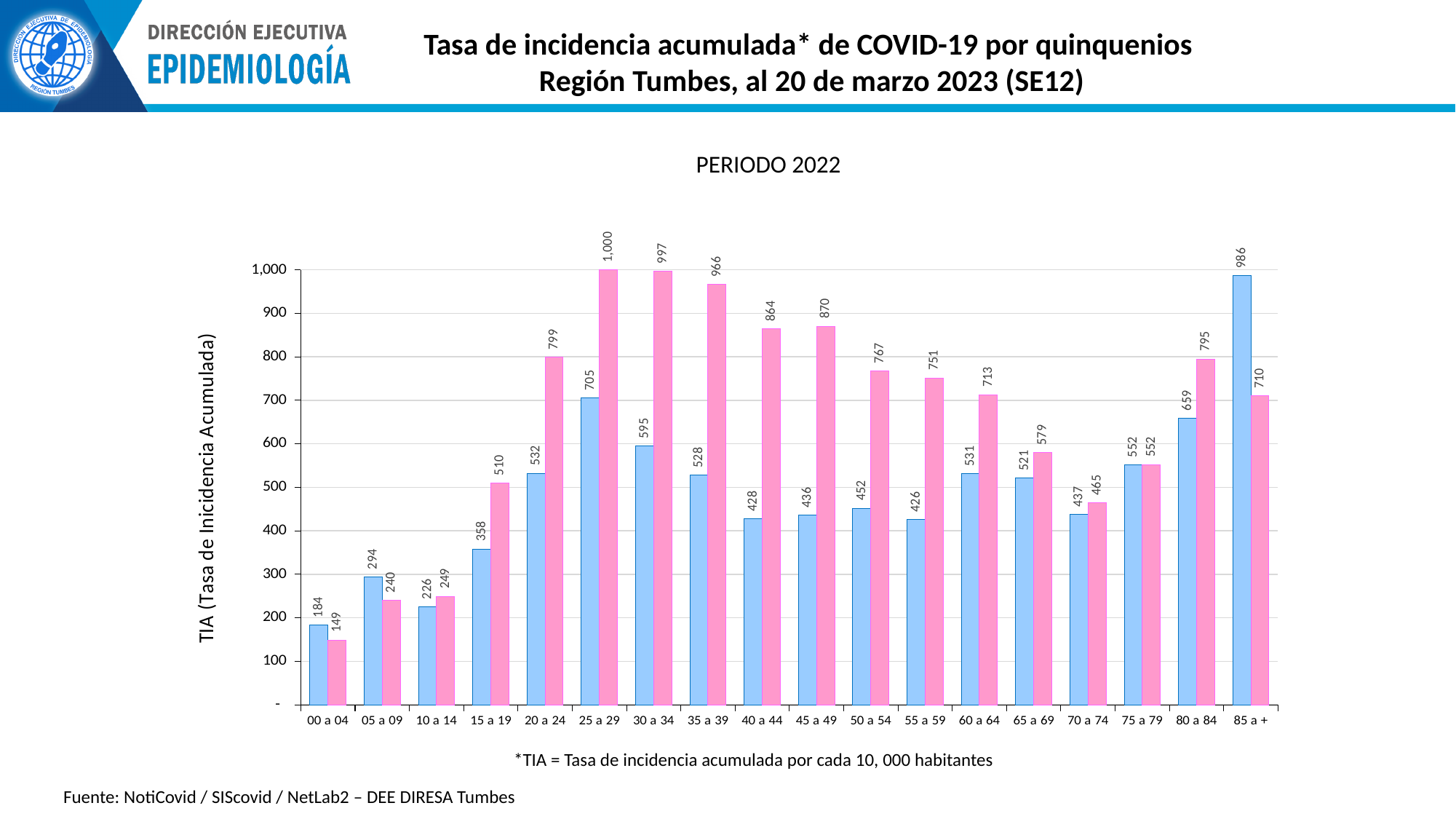
Which age group has the highest pink bar? 25 a 29 What is the difference between the pink and blue bars for the 25 a 29 age group? 295 What is the difference between the blue and pink bars for the 85 a + age group? 276 What is the label of the y axis? TIA (Tasa de Incidencia Acumulada) How many age groups are shown on the x axis? 18 Which age group has the lowest blue bar? 00 a 04 For the 05 a 09 age group, which bar is larger, blue or pink? blue Which age group has the highest blue bar? 85 a + What is the value of the blue bar for the 25 a 29 age group? 705 What is the value of the pink bar for the 45 a 49 age group? 870 What type of chart is shown on the slide? bar chart What is the value of the pink bar for the 00 a 04 age group? 149